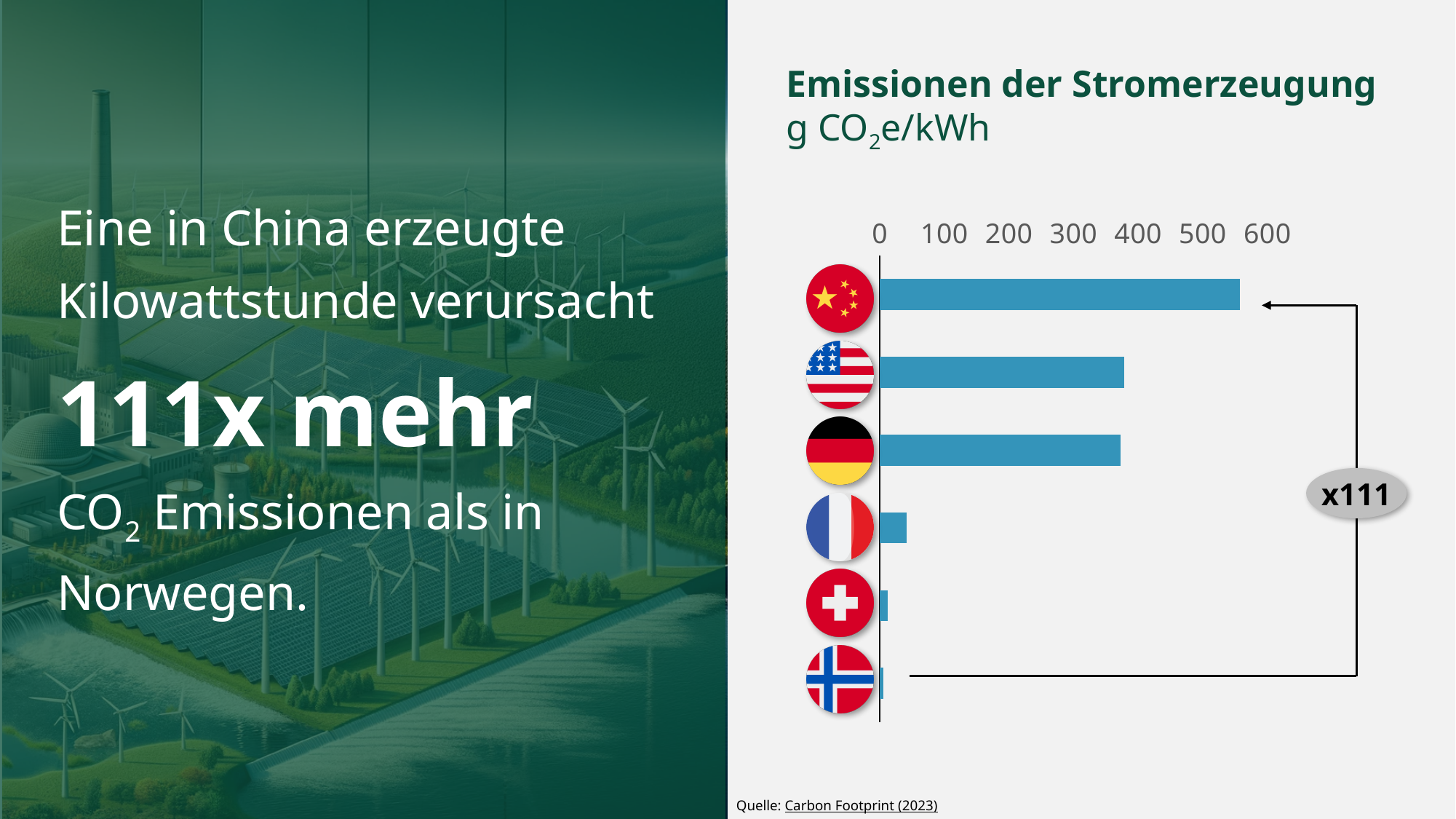
Is the value for Germany greater or less than 400? less Which has the larger value, China or the USA? China What kind of chart is shown on the slide? bar chart Is the value for China greater or less than 500? greater Which country has the lowest emissions in the chart? Norway What is the title of the chart? Emissionen der Stromerzeugung Which has the larger value, Germany or France? Germany How many countries (bars) are shown in the chart? 6 Is the value for France greater or less than 100? less Which country has the highest emissions in the chart? China What factor is shown in the annotation between the China and Norway bars? x111